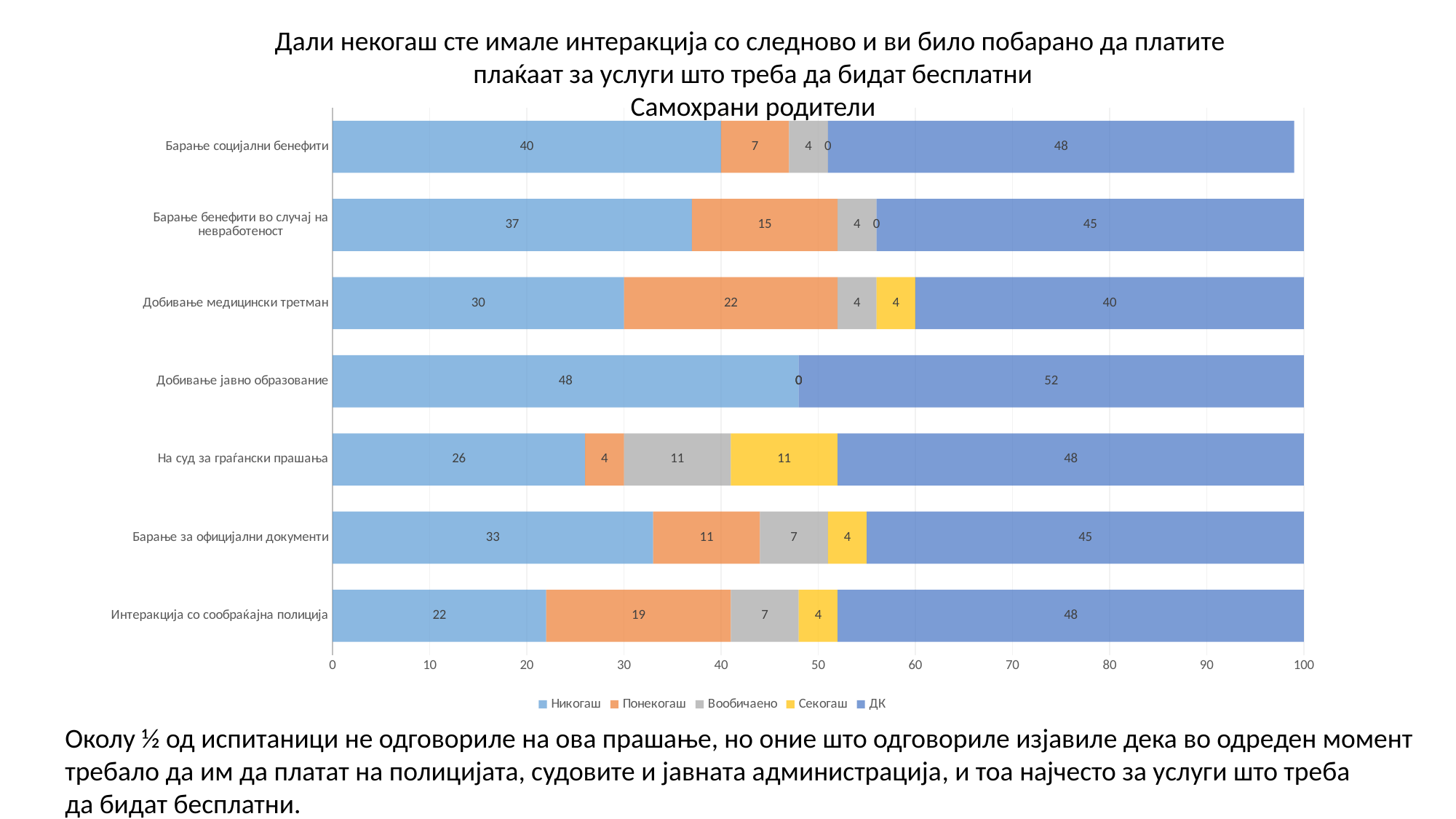
What is the value of ДК for Добивање јавно образование? 52 Which category has the highest value for Понекогаш? Добивање медицински третман What is the total of the stacked bar for Интеракција со сообраќајна полиција? 100 What is the value of Секогаш for На суд за граѓански прашања? 11 Which is larger: the Понекогаш value for Барање бенефити во случај на невработеност or for Барање за официјални документи? Барање бенефити во случај на невработеност What is the value of Понекогаш for Добивање медицински третман? 22 Which category has the highest value for Никогаш? Добивање јавно образование What is the difference between the Никогаш values for Барање социјални бенефити and Интеракција со сообраќајна полиција? 18 How many series does the legend list? 5 Which category has the lowest value for Никогаш? Интеракција со сообраќајна полиција How many categories are shown on the chart? 7 What is the value of Никогаш for Барање социјални бенефити? 40